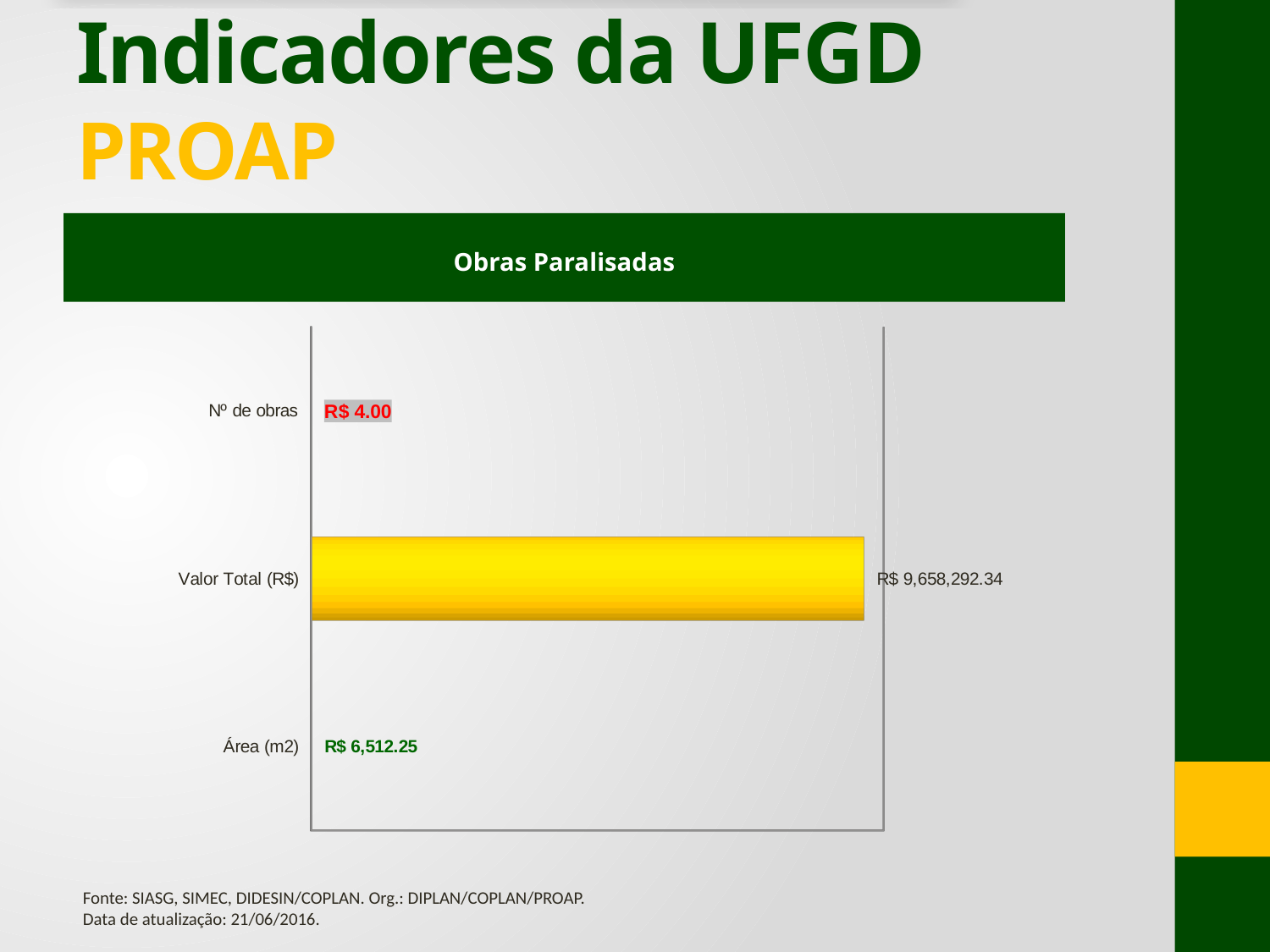
What colour is the bar for "Valor Total (R$)"? yellow What is the value shown for "Valor Total (R$)"? R$ 9,658,292.34 What is the value shown for "Nº de obras"? R$ 4.00 What kind of chart is shown under the title "Obras Paralisadas"? bar chart Which is larger, the value for "Área (m2)" or the value for "Nº de obras"? Área (m2) Which category has the lowest value? Nº de obras Which category has the highest value? Valor Total (R$) How many categories are shown on the chart? 3 What is the title of the chart? Obras Paralisadas What is the difference between the value for "Área (m2)" and the value for "Nº de obras"? R$ 6,508.25 Which category is listed at the top of the chart? Nº de obras What is the value shown for "Área (m2)"? R$ 6,512.25